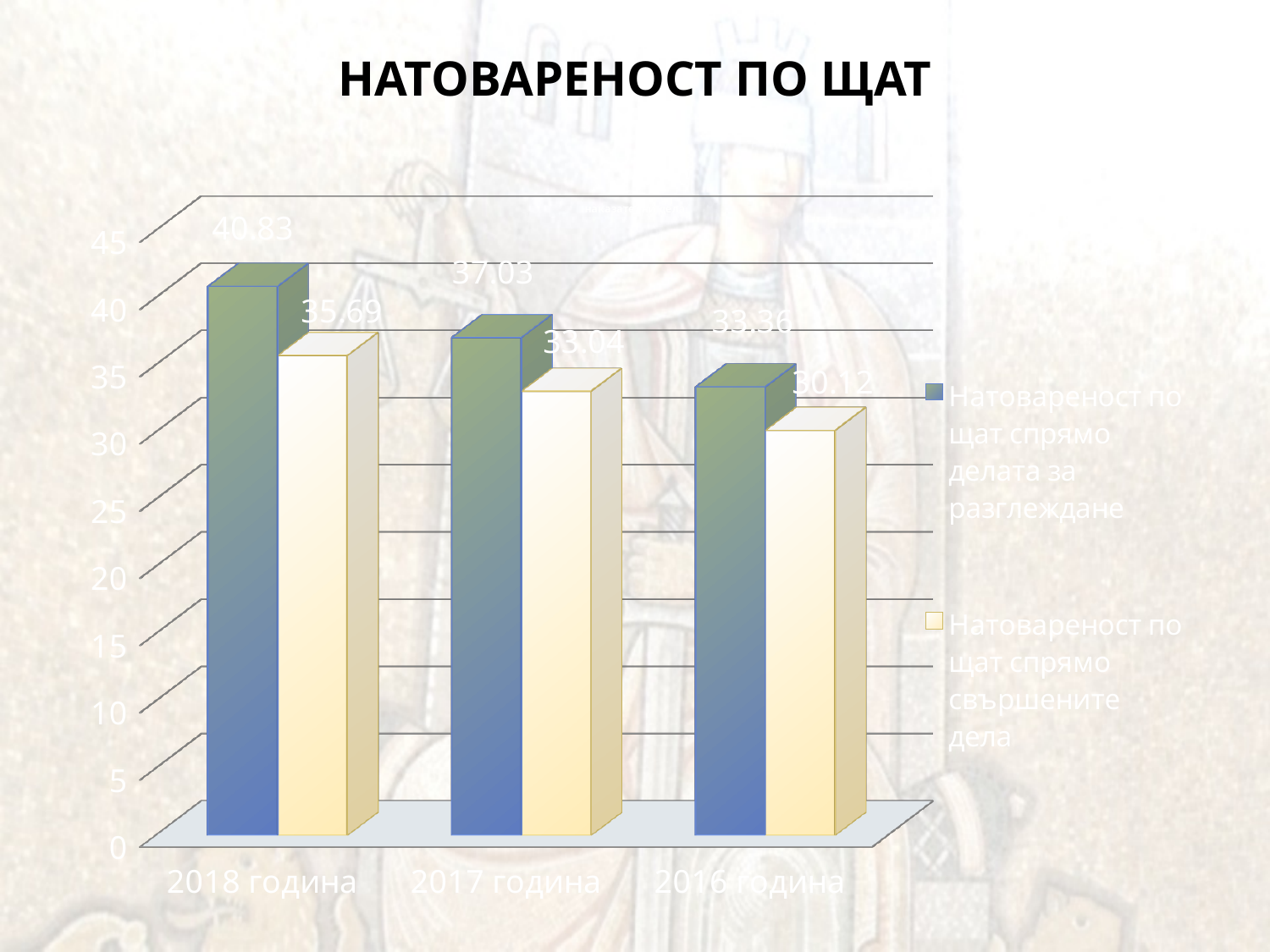
Which year has the lowest value in the series 'Натовареност по щат спрямо свършените дела'? 2016 година Which year has the highest value in the series 'Натовареност по щат спрямо делата за разглеждане'? 2018 година What is the difference between the 'Натовареност по щат спрямо делата за разглеждане' values for 2018 година and 2017 година? 3.8 What is the value for 2016 година in the series 'Натовареност по щат спрямо свършените дела'? 30.12 Which is larger for 2017 година: 'Натовареност по щат спрямо делата за разглеждане' or 'Натовареност по щат спрямо свършените дела'? Натовареност по щат спрямо делата за разглеждане How many year categories are shown on the x axis? 3 What is the value for 2016 година in the series 'Натовареност по щат спрямо делата за разглеждане'? 33.36 How many series does the legend list? 2 What is the value for 2017 година in the series 'Натовареност по щат спрямо свършените дела'? 33.04 What is the value for 2018 година in the series 'Натовареност по щат спрямо делата за разглеждане'? 40.83 What is the difference between the two series values for 2018 година? 5.14 What kind of chart is shown on the slide? Bar chart